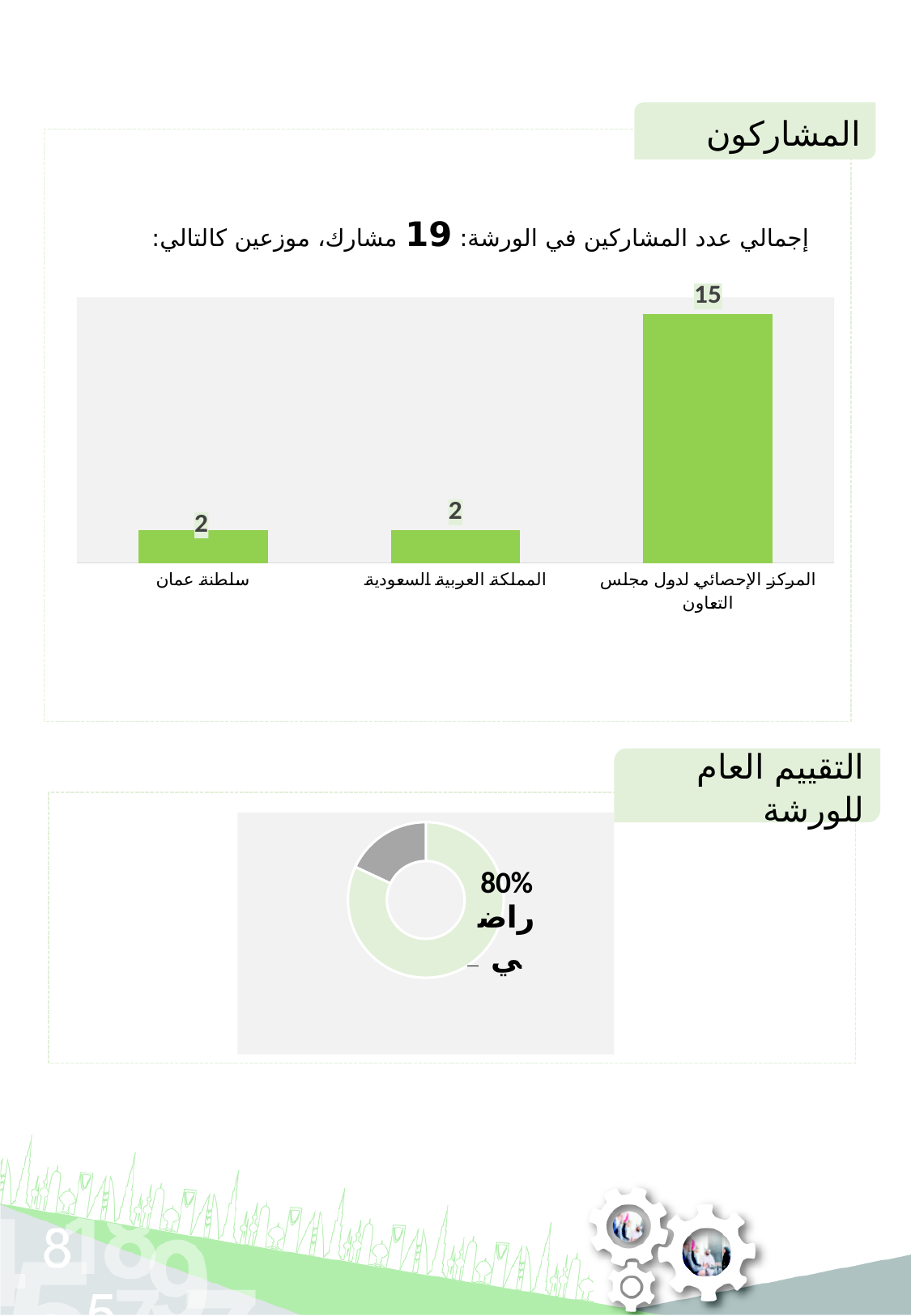
In the bar chart under "المشاركون", what colour are the bars? green In the bar chart under "المشاركون", what is the difference between the value for المركز الإحصائي لدول مجلس التعاون and the value for سلطنة عمان? 13 In the bar chart under "المشاركون", how many participants are from سلطنة عمان? 2 In the bar chart under "المشاركون", how many participants are from المملكة العربية السعودية? 2 What kind of chart is shown under "التقييم العام للورشة"? donut chart In the donut chart under "التقييم العام للورشة", what percentage is labelled راضي? 80% In the bar chart under "المشاركون", which category has the highest value? المركز الإحصائي لدول مجلس التعاون In the bar chart under "المشاركون", which is larger: the value for المركز الإحصائي لدول مجلس التعاون or the value for المملكة العربية السعودية? المركز الإحصائي لدول مجلس التعاون In the bar chart under "المشاركون", how many categories are shown? 3 What kind of chart is shown under "المشاركون"? bar chart In the bar chart under "المشاركون", what is the total of all three bars? 19 In the bar chart under "المشاركون", how many participants are from المركز الإحصائي لدول مجلس التعاون? 15